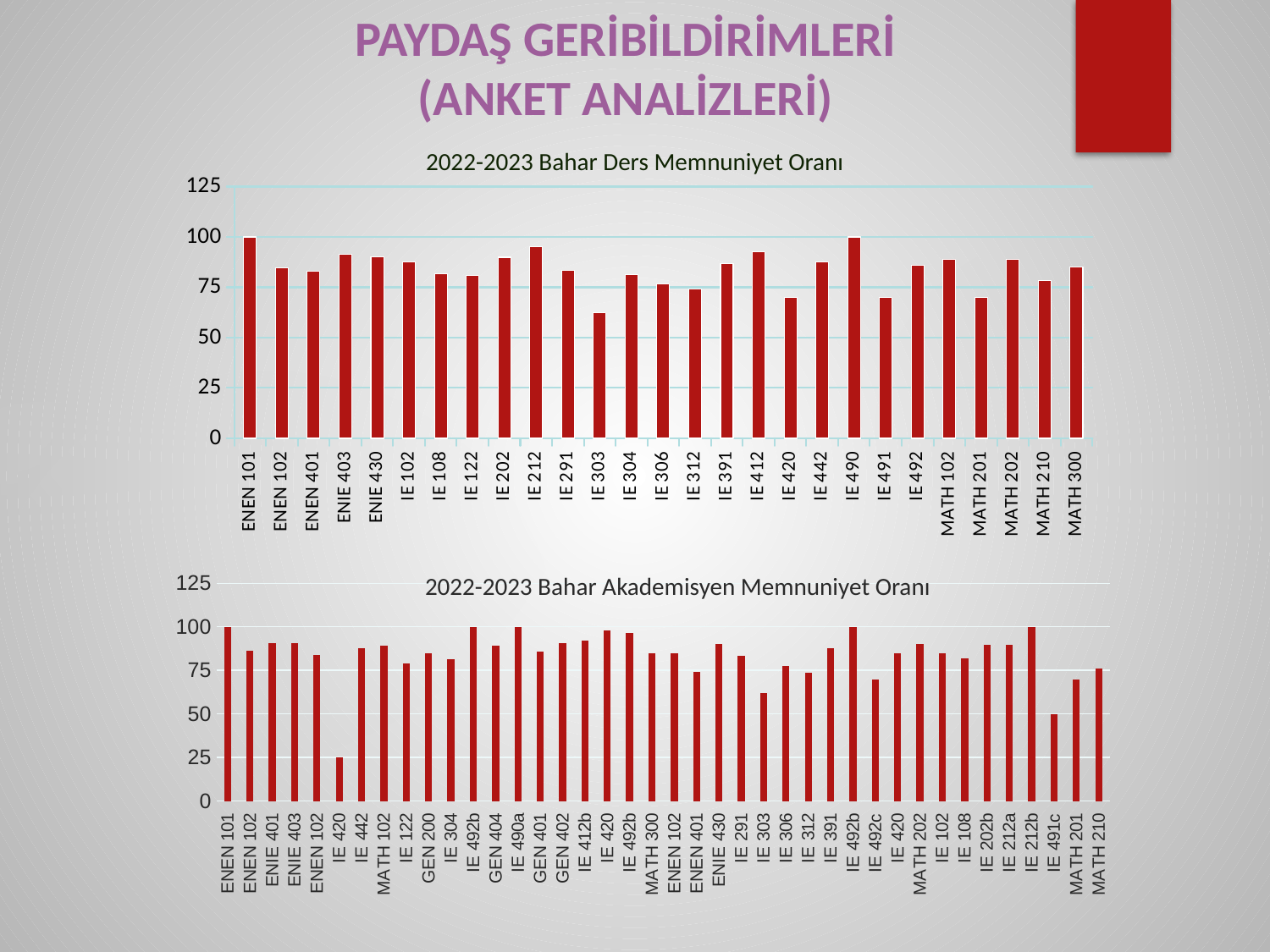
In the '2022-2023 Bahar Ders Memnuniyet Oranı' chart, is the value for IE 303 greater or less than 75? less In the '2022-2023 Bahar Akademisyen Memnuniyet Oranı' chart, which is larger, the value for IE 391 or the value for IE 303? IE 391 In the '2022-2023 Bahar Ders Memnuniyet Oranı' chart, which course has the lowest value? IE 303 In the '2022-2023 Bahar Akademisyen Memnuniyet Oranı' chart, is the value for GEN 404 greater or less than 75? greater In the '2022-2023 Bahar Ders Memnuniyet Oranı' chart, which is larger, the value for IE 212 or the value for IE 303? IE 212 In the '2022-2023 Bahar Akademisyen Memnuniyet Oranı' chart, is the value for IE 303 greater or less than 75? less In the '2022-2023 Bahar Akademisyen Memnuniyet Oranı' chart, which course has the lowest value? IE 420 What colour are the bars in the '2022-2023 Bahar Akademisyen Memnuniyet Oranı' chart? red In the '2022-2023 Bahar Ders Memnuniyet Oranı' chart, how many courses are shown on the x axis? 27 What type of chart is the '2022-2023 Bahar Ders Memnuniyet Oranı' chart? bar chart What is the title of the top chart on the slide? 2022-2023 Bahar Ders Memnuniyet Oranı